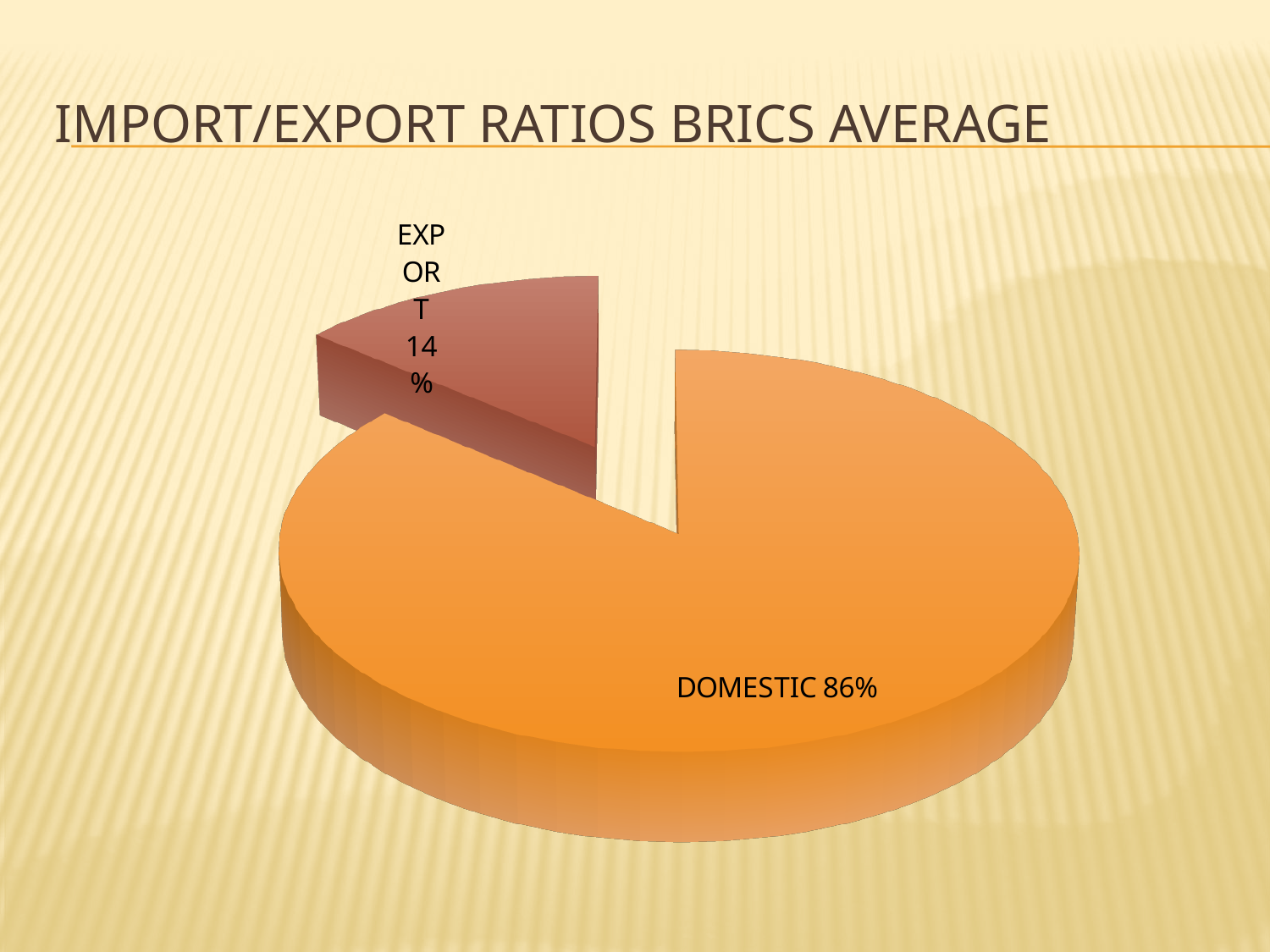
Which slice is the smallest in the pie chart? EXPORT Which slice is the largest in the pie chart? DOMESTIC What is the difference in percentage points between the DOMESTIC and EXPORT slices? 72 What colour is the EXPORT slice? Brown How many slices does the pie chart have? 2 What share of the pie does EXPORT represent? 14% What share of the pie does DOMESTIC represent? 86% What is the title of the slide? IMPORT/EXPORT RATIOS BRICS AVERAGE Which is larger, the DOMESTIC slice or the EXPORT slice? DOMESTIC What kind of chart is shown on the slide? Pie chart